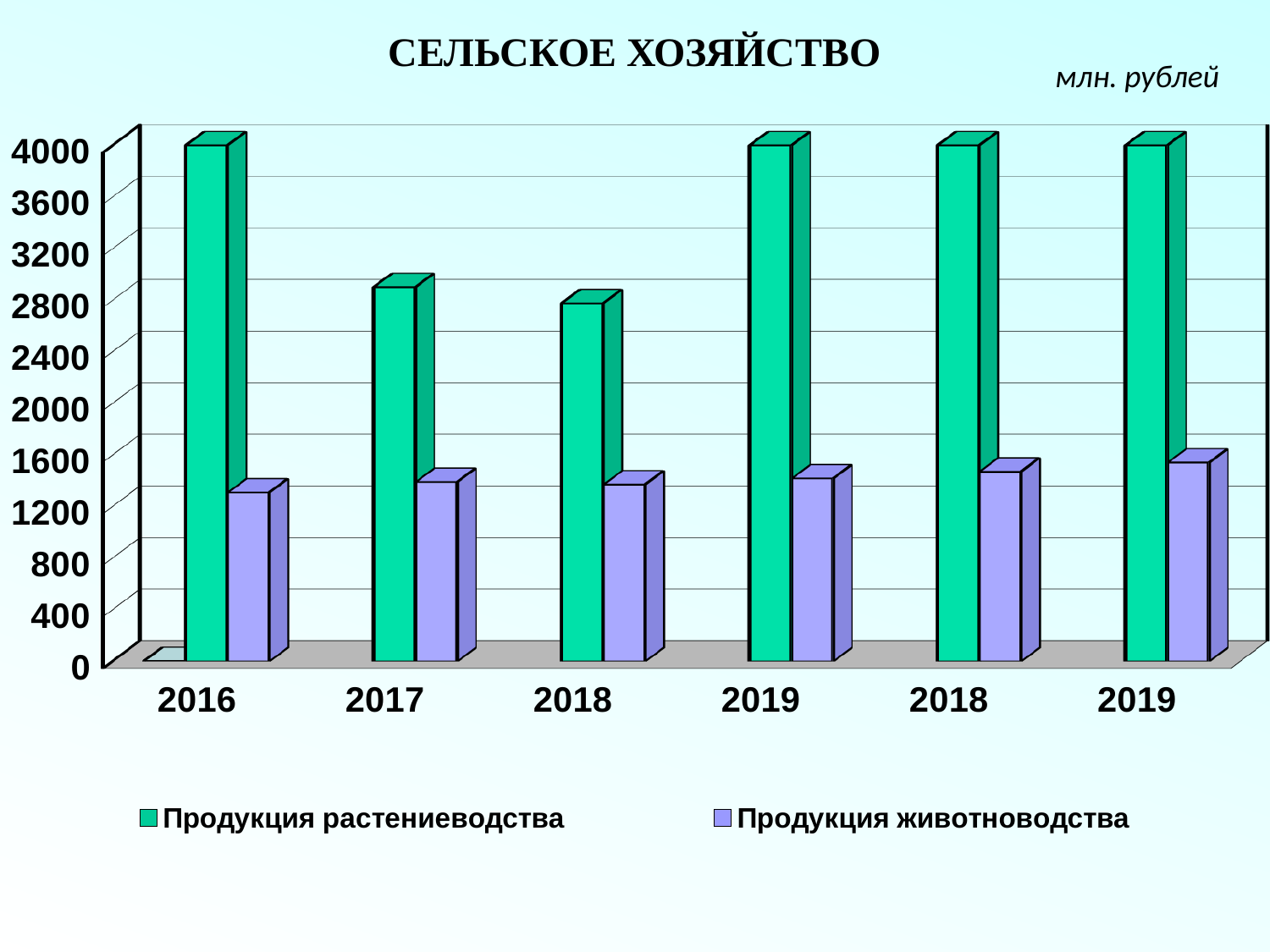
For Продукция растениеводства, which is larger: the value in 2017 or the value in the first 2019 group? 2019 What is the title of the chart? СЕЛЬСКОЕ ХОЗЯЙСТВО Is the value for Продукция растениеводства in 2017 greater or less than 2400? greater Is the value for Продукция животноводства in 2016 greater or less than 1600? less How many category groups are shown along the x axis? 6 In 2016, which is larger: Продукция растениеводства or Продукция животноводства? Продукция растениеводства In what units are the values on the chart given? млн. рублей How many series does the legend list? 2 Is the value for Продукция растениеводства in the first 2018 group greater or less than 3200? less What kind of chart is shown on the slide? bar chart